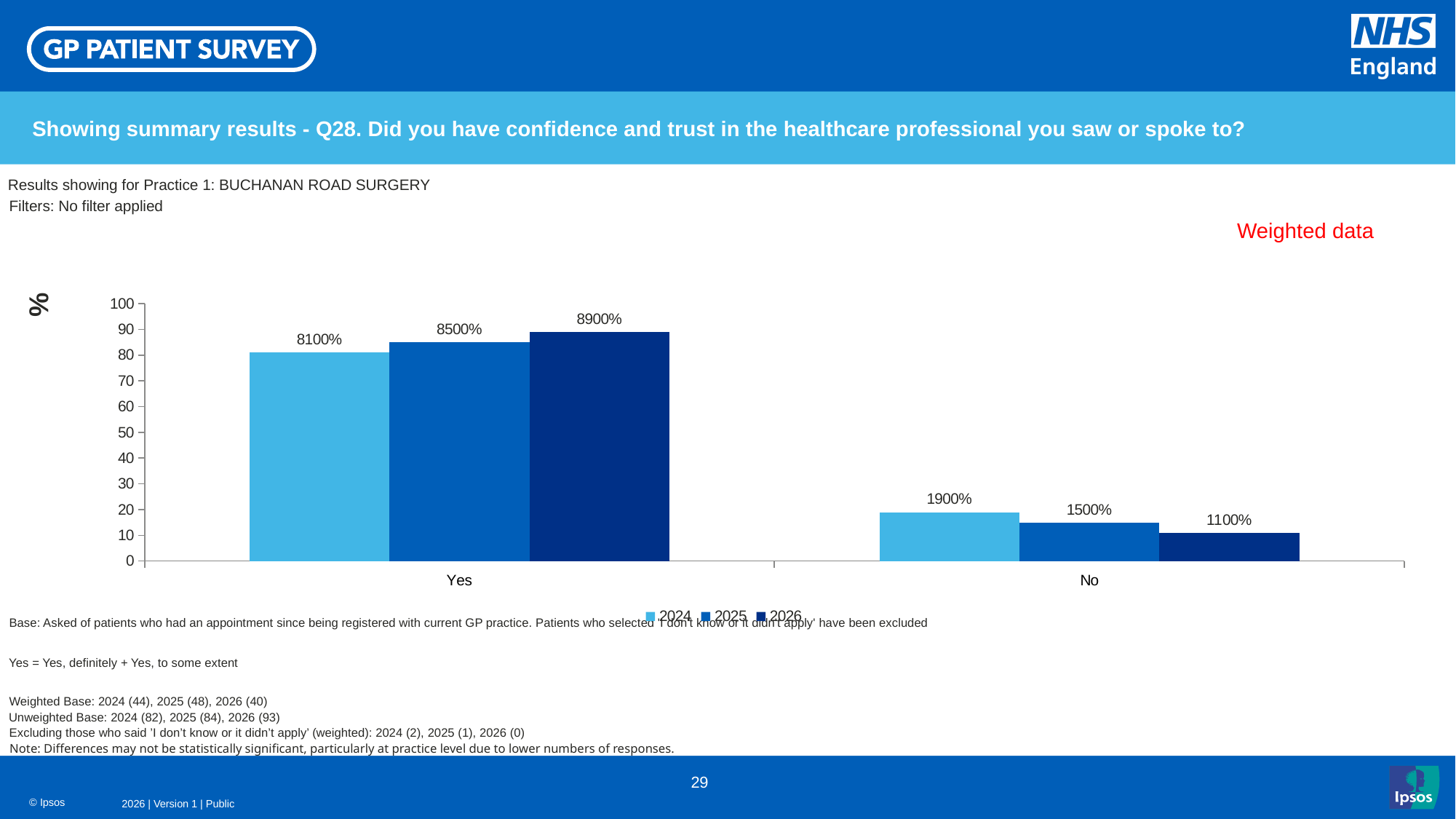
How many categories are shown on the x axis? 2 Which year has the tallest bar in the Yes category? 2026 Which year has the shortest bar in the No category? 2026 How many series does the legend list? 3 Is the 2025 bar in the Yes category taller or shorter than the 2024 bar in the Yes category? taller What is the data label shown for the 2025 series in the No category? 1500% What kind of chart is shown on the slide? bar chart Across the years 2024, 2025 and 2026, do the bars in the No category rise or fall? fall What is the data label shown for the 2024 series in the Yes category? 8100% What is the data label shown for the 2026 series in the Yes category? 8900% What is the data label shown for the 2026 series in the No category? 1100% Is the 2024 bar in the No category above or below the 10 mark on the y axis? above